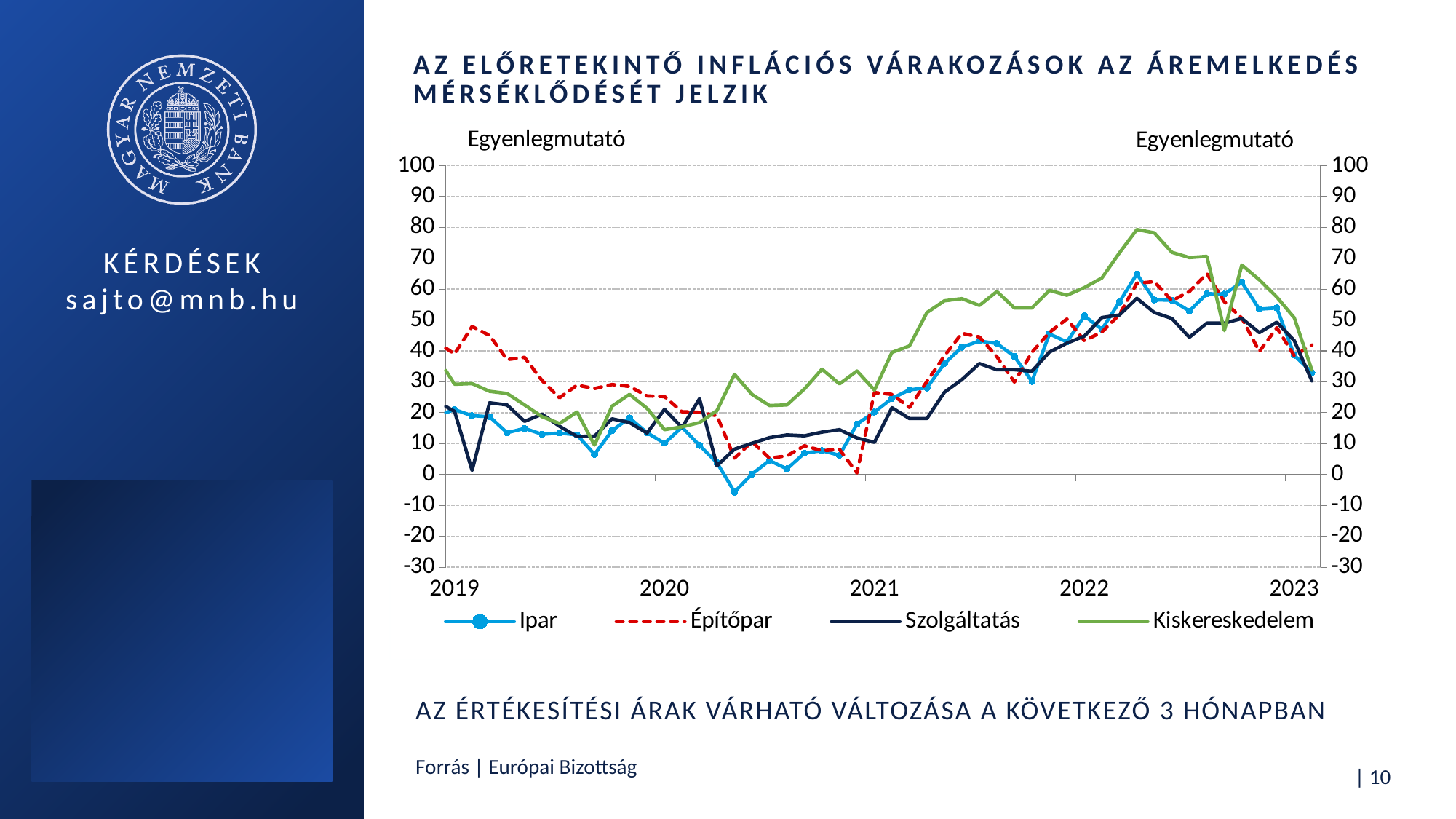
How many series does the legend list? 4 What label is shown above the vertical axes? Egyenlegmutató Do the series generally rise or fall from their 2022 peaks to the start of 2023? fall Is the lowest value of Ipar in 2020 greater or less than 0? less Is the value of Építőpar at the start of 2019 greater or less than 30? greater What kind of chart is shown on the slide? line chart At the 2022 peak, which is higher: Kiskereskedelem or Szolgáltatás? Kiskereskedelem Which series are listed in the legend? Ipar, Építőpar, Szolgáltatás, Kiskereskedelem Which series falls to the lowest value anywhere on the chart? Ipar Do the series generally rise or fall between the start of 2021 and mid-2022? rise Is the peak value of Kiskereskedelem in 2022 greater or less than 70? greater Which series reaches the highest value anywhere on the chart? Kiskereskedelem